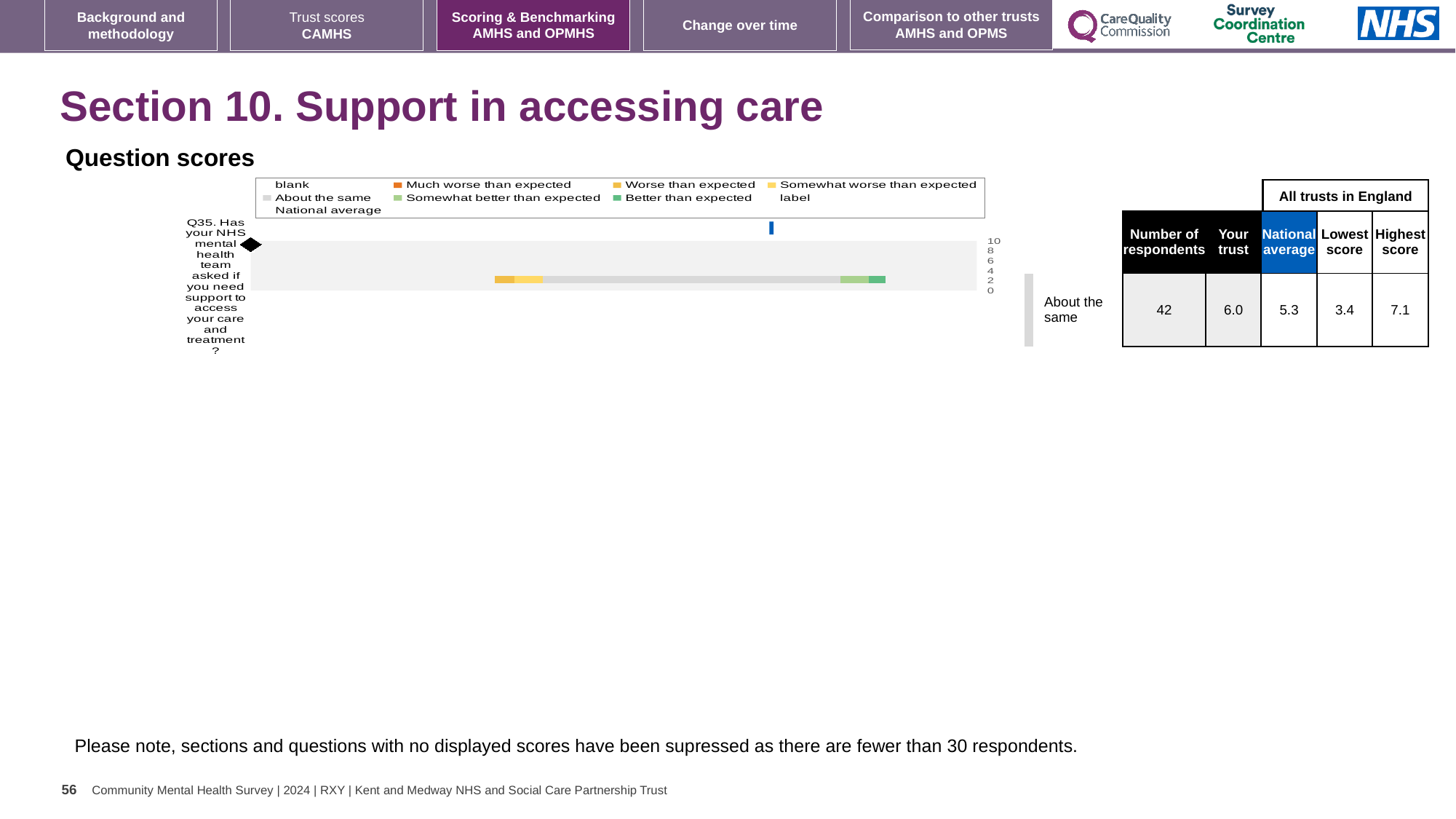
What is the lowest score among all trusts in England for Q35? 3.4 How many questions are plotted in the Question scores chart? 1 What is the national average score for Q35 shown in the table? 5.3 What is the highest value shown on the chart's score axis? 10 What benchmark category is the trust's Q35 score assigned to, as labelled beside the chart? About the same How many respondents answered Q35? 42 By how much does the trust's score for Q35 exceed the national average? 0.7 According to the table next to the chart, what is the 'Your trust' score for Q35? 6.0 Which is larger for Q35: the trust's score or the national average? Your trust (6.0) What is the difference between the highest score (7.1) and the lowest score (3.4) for Q35? 3.7 What is the highest score among all trusts in England for Q35? 7.1 What kind of chart is used to show the Q35 question score? bar chart